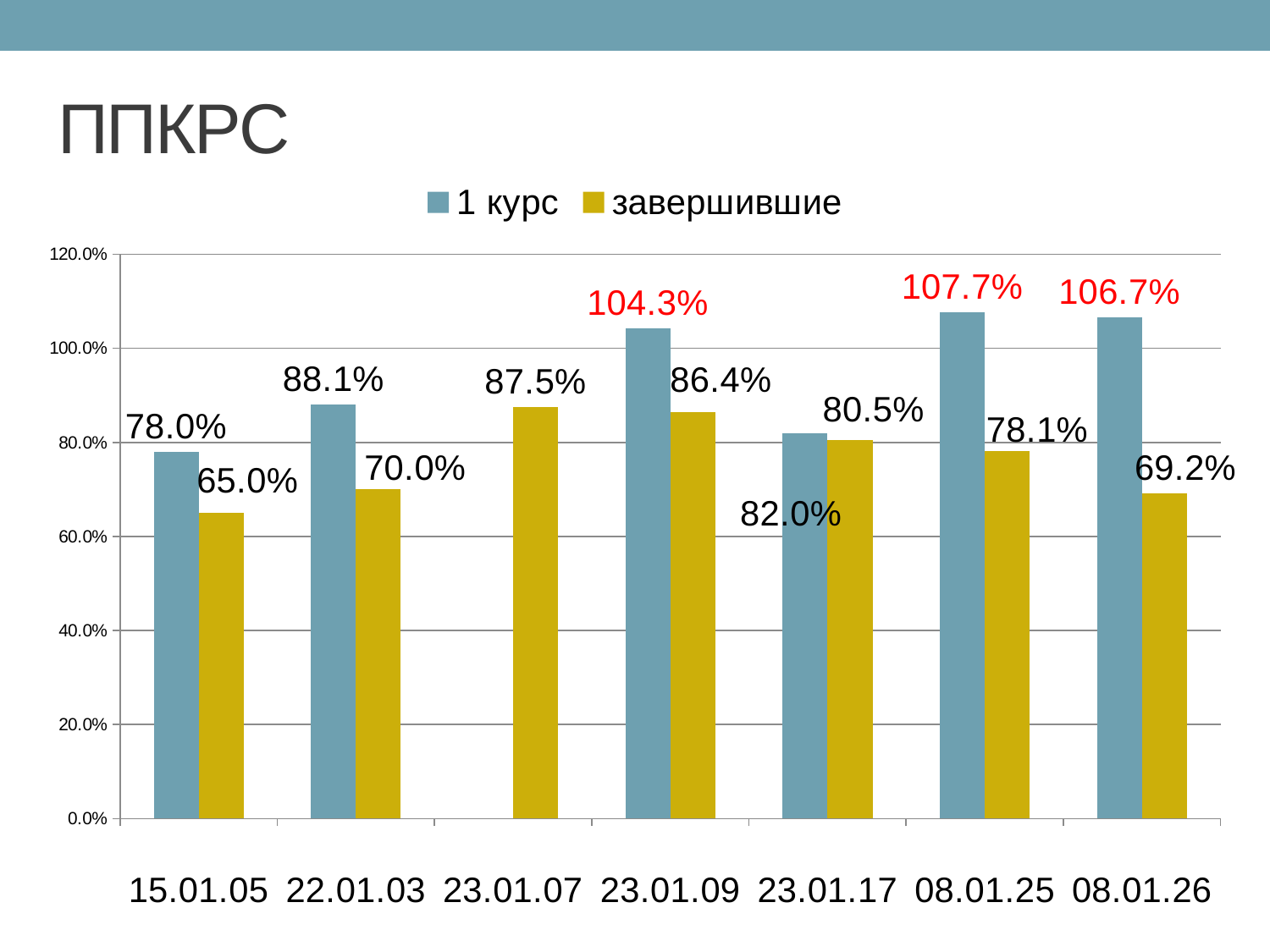
What type of chart is shown on the slide? bar chart How many series does the legend list? 2 Which category has the lowest value for 'завершившие'? 15.01.05 Is the value of '1 курс' for 08.01.26 greater or less than 100.0%? greater What is the difference between '1 курс' and 'завершившие' for 15.01.05? 13.0% What is the value of 'завершившие' for 23.01.07? 87.5% What is the title of the slide containing the chart? ППКРС What is the value of '1 курс' for 23.01.09? 104.3% What is the value of 'завершившие' for 08.01.26? 69.2% How many categories are shown on the x axis? 7 Which category has the highest value for '1 курс'? 08.01.25 Which is larger for 23.01.17: '1 курс' or 'завершившие'? 1 курс